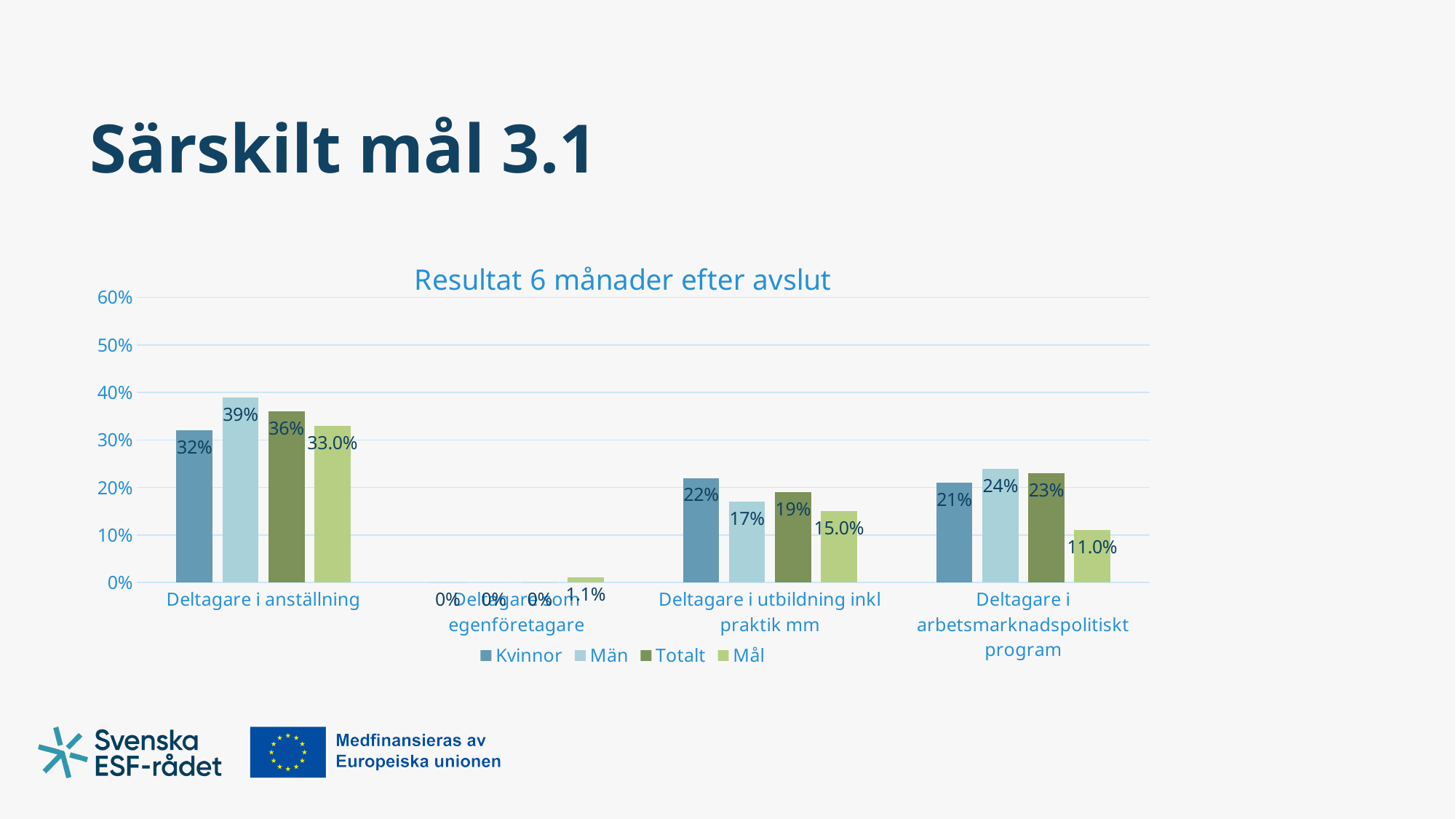
What is the value for Män in the Deltagare i anställning category? 39% What is the Mål value for Deltagare i arbetsmarknadspolitiskt program? 11.0% What is the difference between the Män and Kvinnor values for Deltagare i anställning? 7 percentage points Which category has the highest Totalt value? Deltagare i anställning Is the Män value for Deltagare i anställning greater or less than 30%? greater Which series has the lowest value in the Deltagare i arbetsmarknadspolitiskt program category? Mål How many series does the legend list? 4 In the Deltagare i utbildning inkl praktik mm category, which is larger: Kvinnor or Män? Kvinnor What kind of chart is shown on the slide? Bar chart What is the title of the chart? Resultat 6 månader efter avslut What is the value for Kvinnor in the Deltagare i utbildning inkl praktik mm category? 22% What is the Totalt value for Deltagare i anställning? 36%